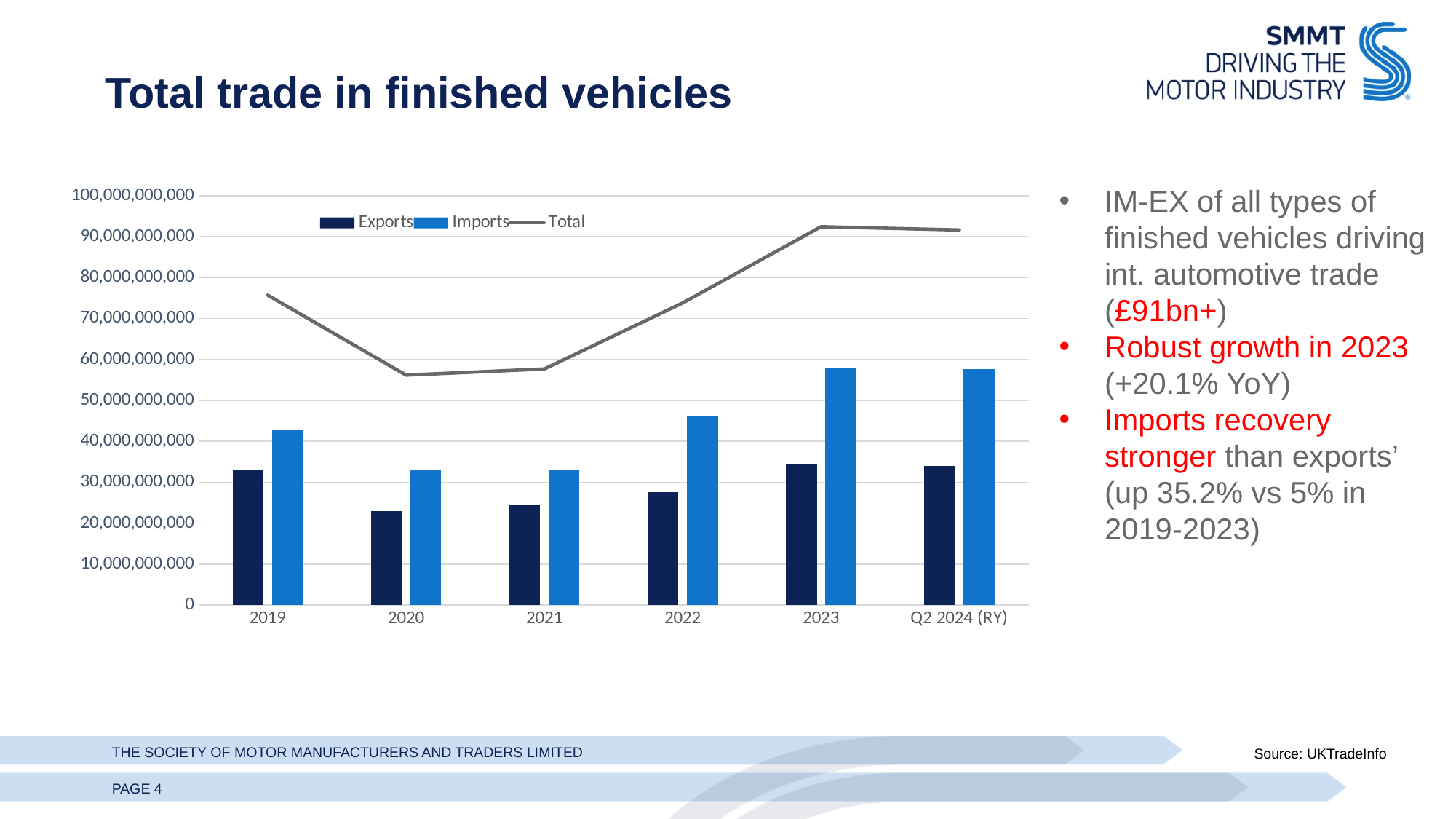
Does the Total line rise or fall from 2020 to 2023? rise Is the value for Imports in 2019 greater or less than 40,000,000,000? greater How many series does the chart legend list? 3 Which year has the lowest Exports value? 2020 Is the value for Exports in 2020 greater or less than 30,000,000,000? less Is the value for Imports in 2023 greater or less than 50,000,000,000? greater What kind of chart is shown on the slide? bar chart with a line How many categories are shown on the x axis of the chart? 6 In 2022, which is larger, Exports or Imports? Imports What is the title of the chart slide? Total trade in finished vehicles